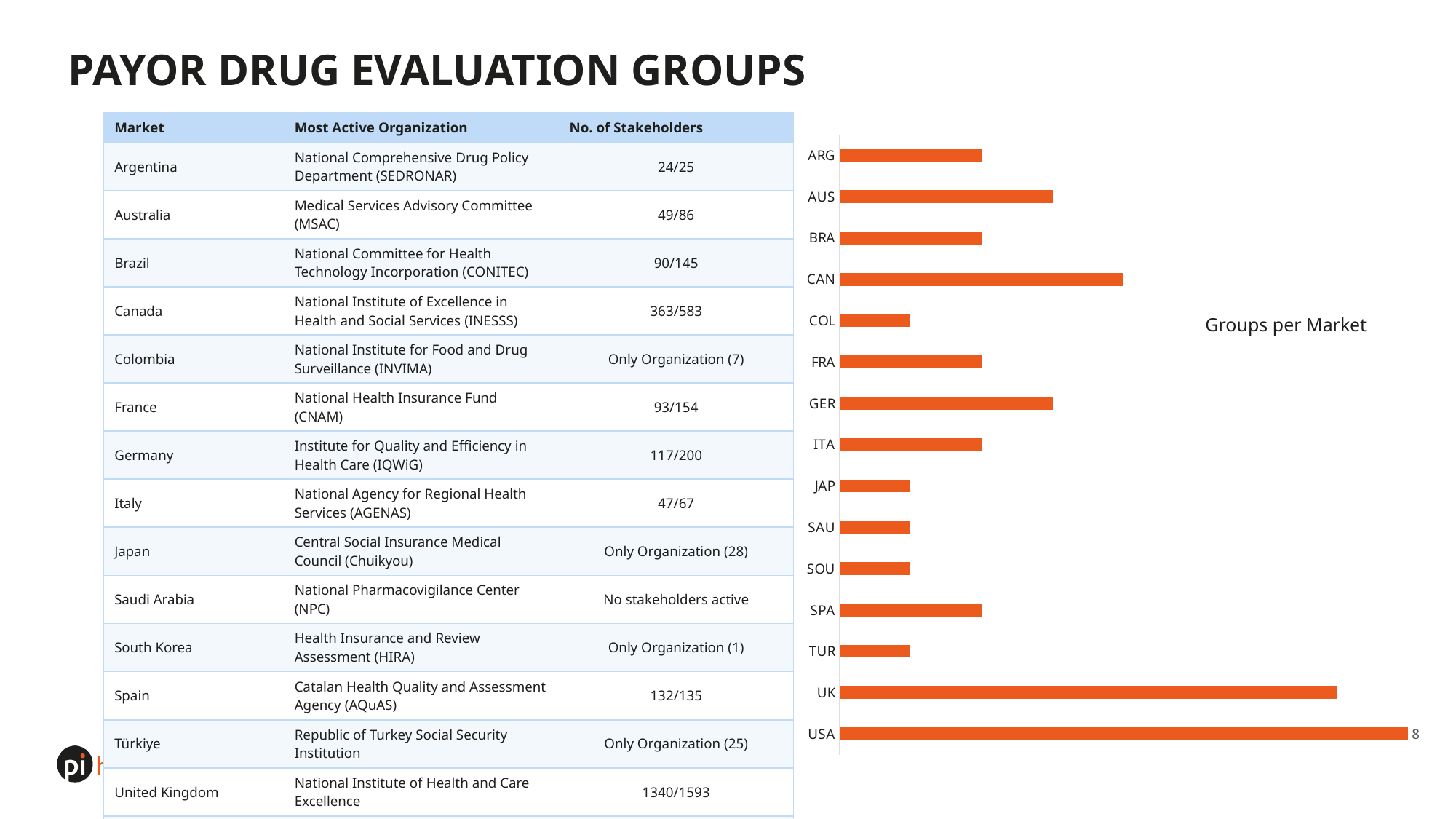
What value is labelled on the USA bar in the Groups per Market chart? 8 What colour are the bars in the Groups per Market chart? orange In the Groups per Market chart, which has the larger value, USA or UK? USA What kind of chart is shown on the right of the slide? bar chart In the Groups per Market chart, which has the larger value, ARG or JAP? ARG Which market has the highest value in the Groups per Market chart? USA In the Groups per Market chart, which has the larger value, CAN or AUS? CAN How many markets are plotted in the Groups per Market chart? 15 What is the title of the bar chart on the slide? Groups per Market